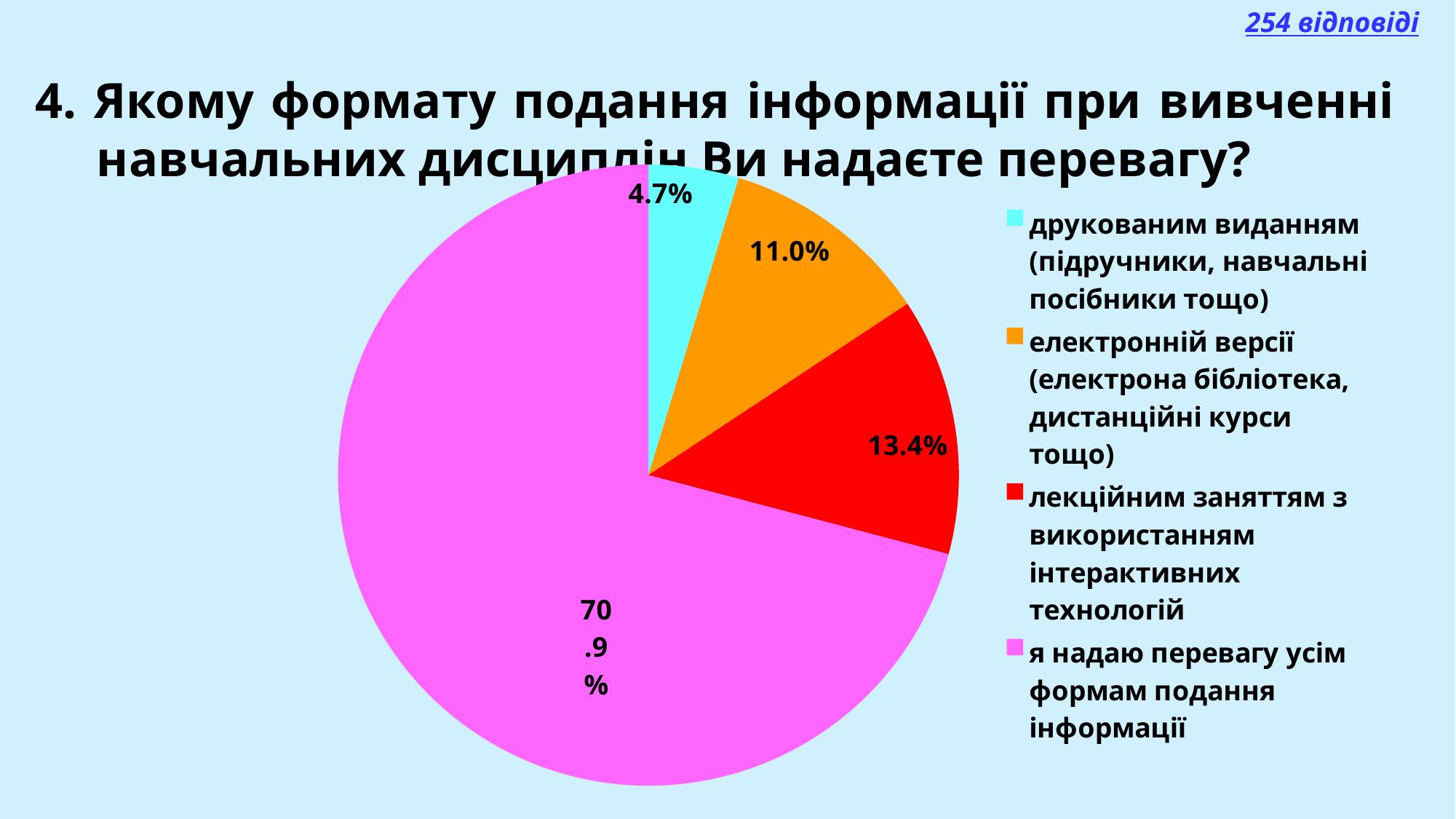
What percentage is shown for the slice "електронній версії (електрона бібліотека, дистанційні курси тощо)"? 11.0% What percentage is shown for the slice "я надаю перевагу усім формам подання інформації"? 70.9% Which slice is larger: "електронній версії" or "друкованим виданням"? електронній версії What type of chart is shown on the slide? pie chart What percentage is shown for the slice "лекційним заняттям з використанням інтерактивних технологій"? 13.4% How many responses does the slide say the chart is based on? 254 відповіді What percentage is shown for the slice "друкованим виданням (підручники, навчальні посібники тощо)"? 4.7% How many slices does the pie chart have? 4 Which category has the largest share of the pie? я надаю перевагу усім формам подання інформації What colour is the slice for "лекційним заняттям з використанням інтерактивних технологій"? red What is the difference in percentage points between the "лекційним заняттям з використанням інтерактивних технологій" slice and the "електронній версії" slice? 2.4 Which category has the smallest share of the pie? друкованим виданням (підручники, навчальні посібники тощо)